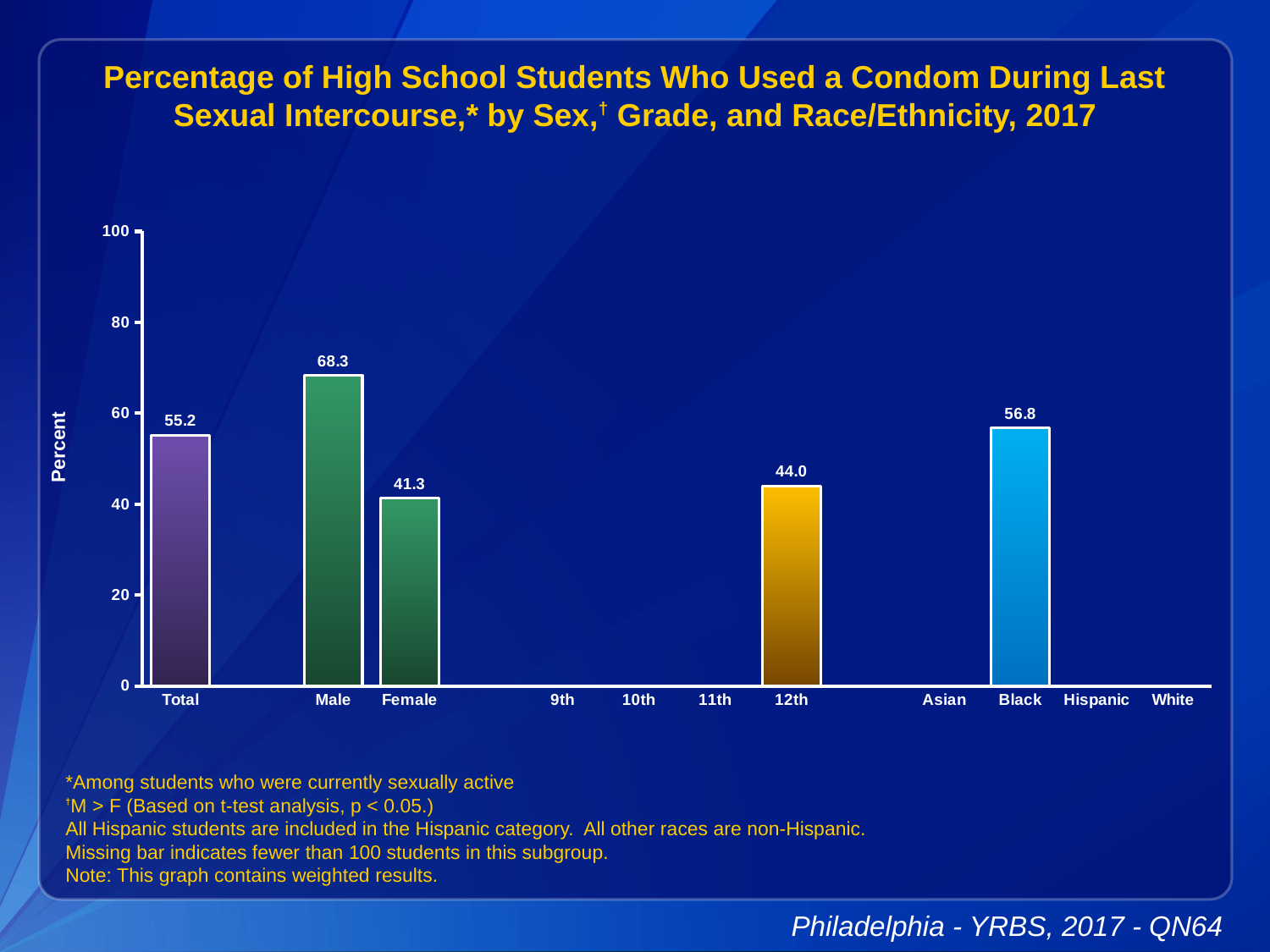
What kind of chart is shown? bar chart What is the difference between the Male and Female values? 27.0 What is the value for Male? 68.3 Which category has the highest value? Male What is the value for 12th grade? 44.0 What is the value for Female? 41.3 Is the value for 12th grade greater or less than 60? less Which category with a plotted bar has the lowest value? Female What is the value for Black students? 56.8 How many categories have a bar plotted? 5 What is the value for Total? 55.2 Which is larger, the value for Black or the value for Total? Black